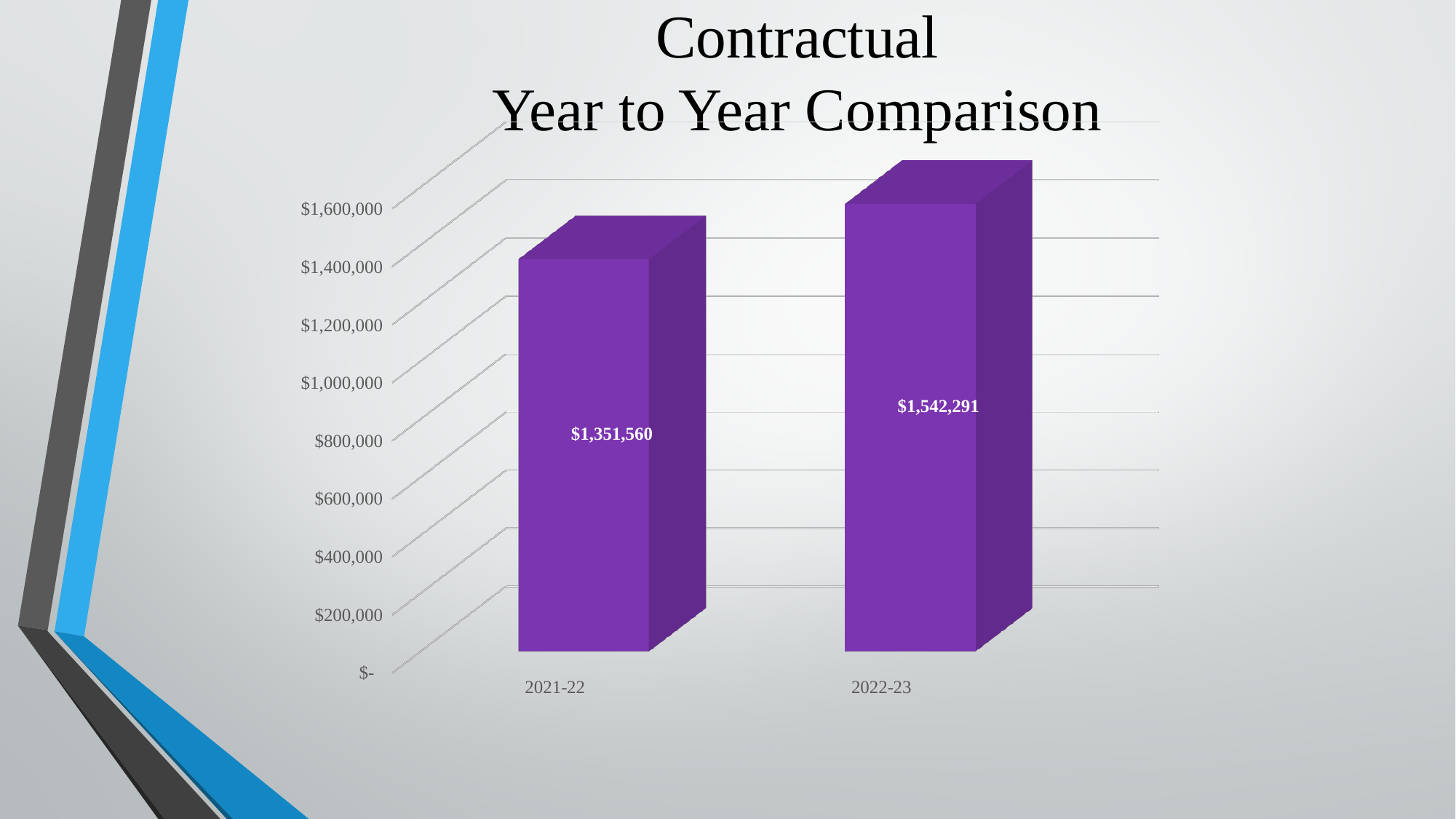
Is the value for 2021-22 larger or smaller than the value for 2022-23? smaller Which year has the higher contractual value? 2022-23 How many years are shown on the chart? 2 Is the value for 2022-23 greater or less than $1,400,000? greater What is the contractual value for 2021-22? $1,351,560 Which year has the lower contractual value? 2021-22 What is the title of the chart? Contractual Year to Year Comparison What is the difference between the 2022-23 and 2021-22 contractual values? $190,731 Is the value for 2021-22 greater or less than $1,600,000? less What kind of chart is shown on the slide? bar chart What is the contractual value for 2022-23? $1,542,291 Do the values rise or fall from 2021-22 to 2022-23? rise